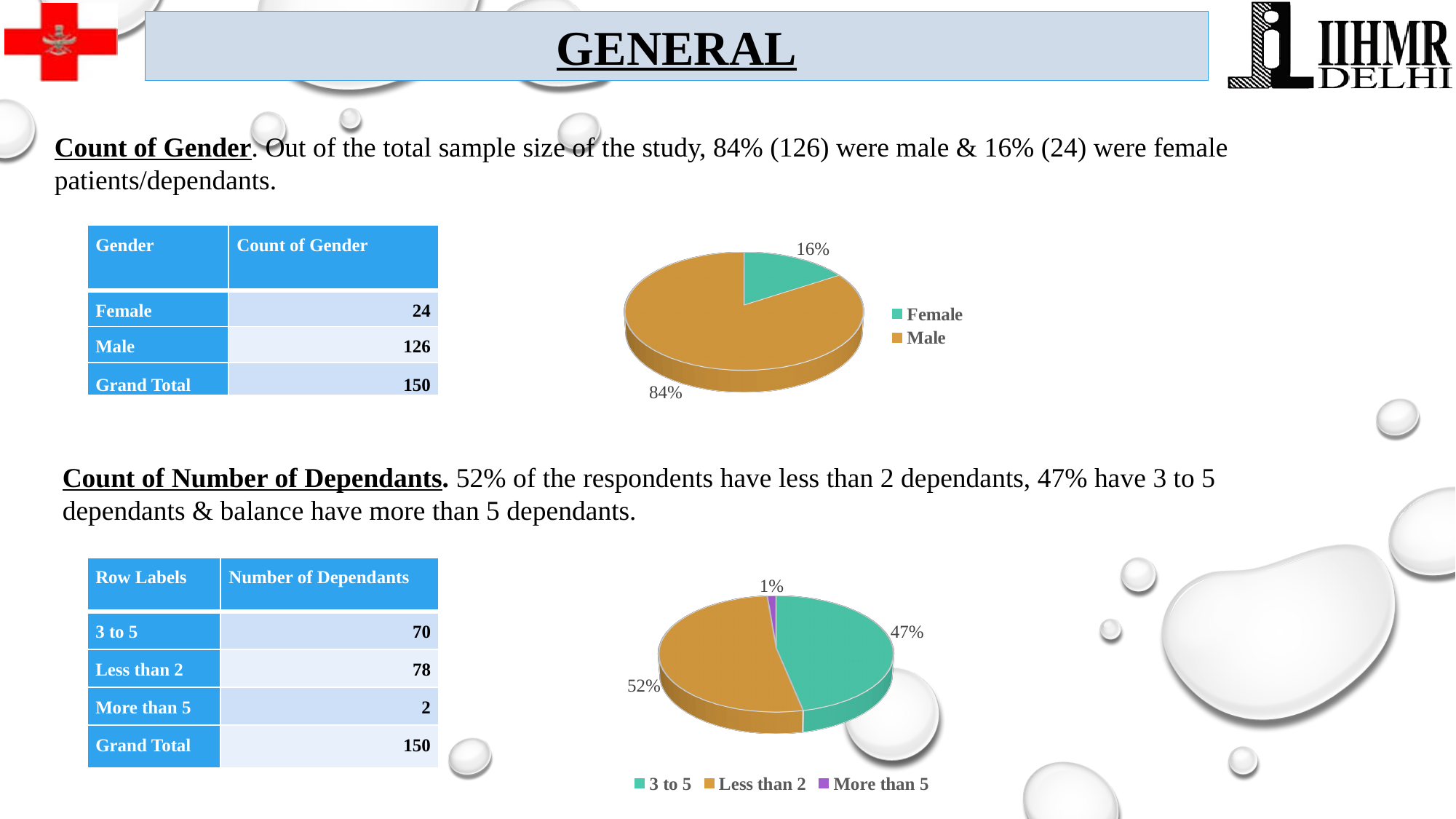
In the upper pie chart, which category has the largest slice? Male In the lower pie chart, which category has the smallest slice? More than 5 In the lower pie chart, what percentage is shown for the 'More than 5' slice? 1% What type of chart is the upper chart on the slide? Pie chart In the lower pie chart, what percentage is shown for the '3 to 5' slice? 47% How many entries does the legend of the upper pie chart list? 2 In the upper pie chart, what percentage is shown for the Female slice? 16% In the lower pie chart, what percentage is shown for the 'Less than 2' slice? 52% In the upper pie chart, what is the difference in percentage points between the Male and Female slices? 68 In the lower pie chart, what colour is the 'More than 5' slice? Purple In the upper pie chart, what percentage is shown for the Male slice? 84% How many categories does the lower pie chart show? 3